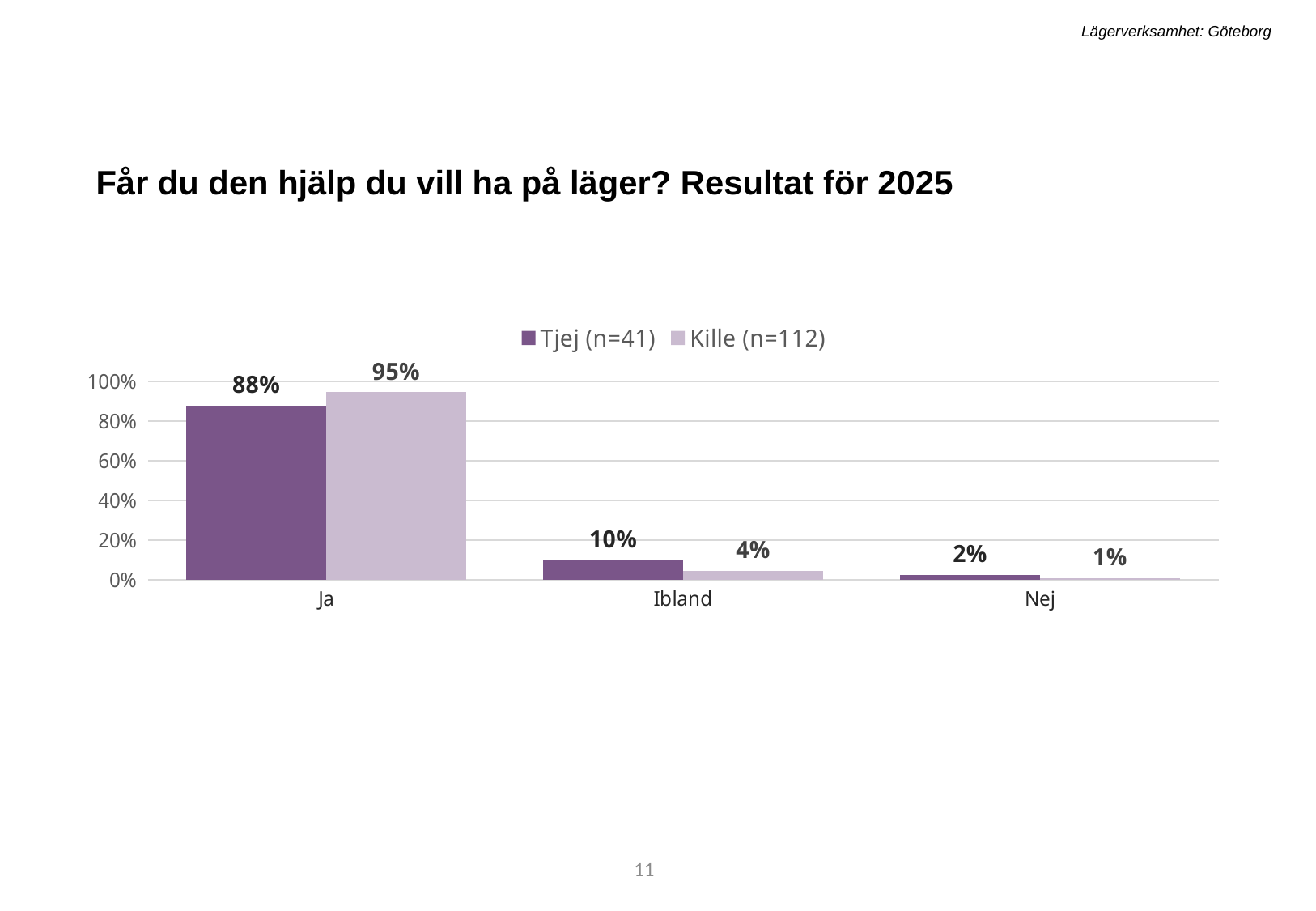
In the Ibland category, which series has the larger value, Tjej (n=41) or Kille (n=112)? Tjej (n=41) What kind of chart is shown on the slide? Bar chart What is the difference between the Kille (n=112) and Tjej (n=41) values in the Ja category? 7% What is the title of the slide? Får du den hjälp du vill ha på läger? Resultat för 2025 Which category has the highest value for Kille (n=112)? Ja How many categories are shown on the x axis? 3 What is the value for Tjej (n=41) in the Ibland category? 10% What is the value for Tjej (n=41) in the Ja category? 88% How many series does the legend list? 2 What is the value for Kille (n=112) in the Ja category? 95% What is the value for Kille (n=112) in the Nej category? 1% Which category has the lowest value for Tjej (n=41)? Nej